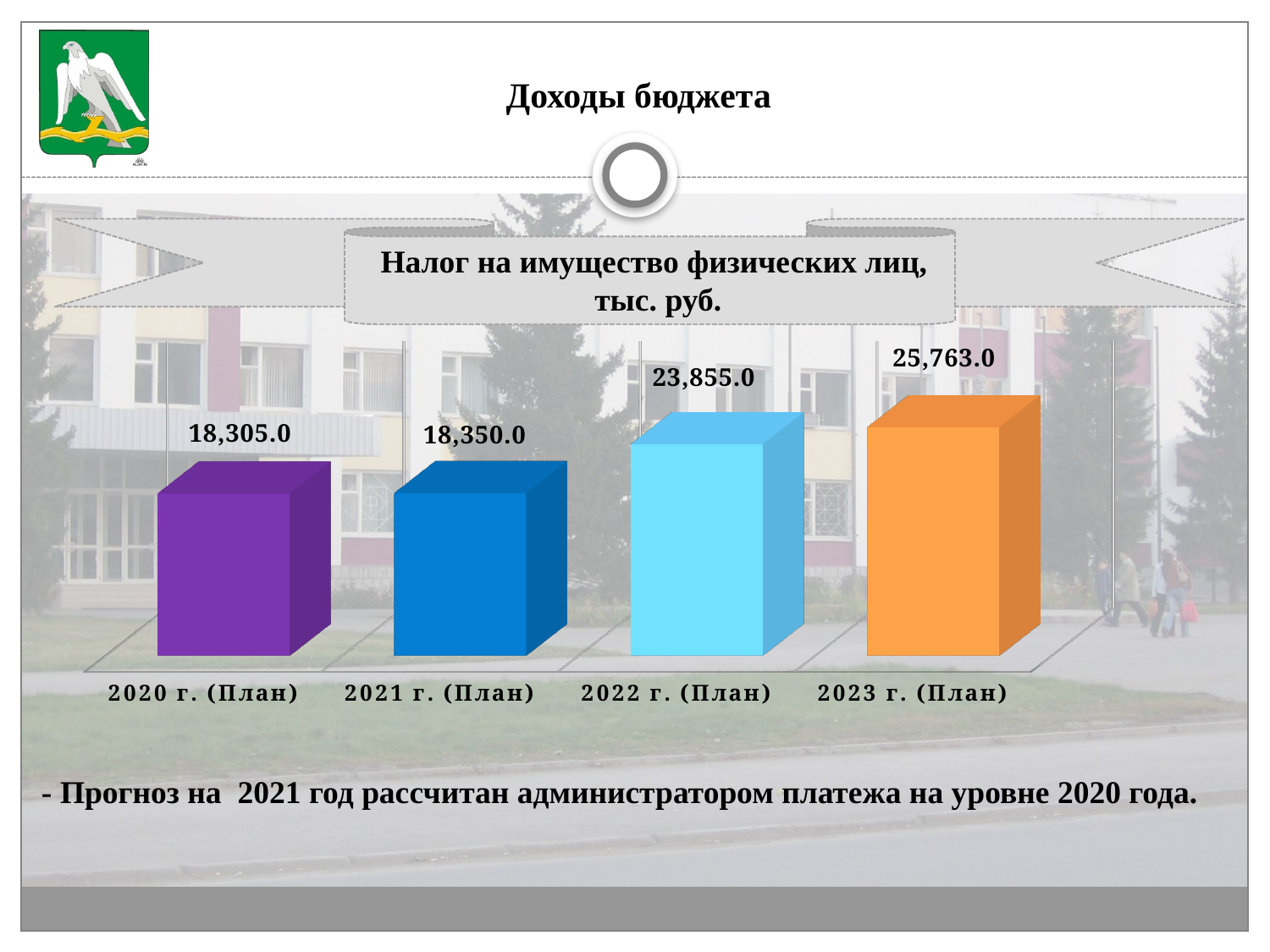
How many categories are shown in the chart? 4 What is the value for 2021 г. (План)? 18,350.0 What kind of chart is shown? Bar chart Which year has the highest value? 2023 г. (План) What is the difference between the values for 2022 г. (План) and 2021 г. (План)? 5,505.0 What is the value for 2023 г. (План)? 25,763.0 What is the value for 2020 г. (План)? 18,305.0 Which is larger, the value for 2022 г. (План) or 2023 г. (План)? 2023 г. (План) What is the difference between the values for 2023 г. (План) and 2020 г. (План)? 7,458.0 Do the values rise or fall from 2020 to 2023? Rise Which year has the lowest value? 2020 г. (План) What is the value for 2022 г. (План)? 23,855.0